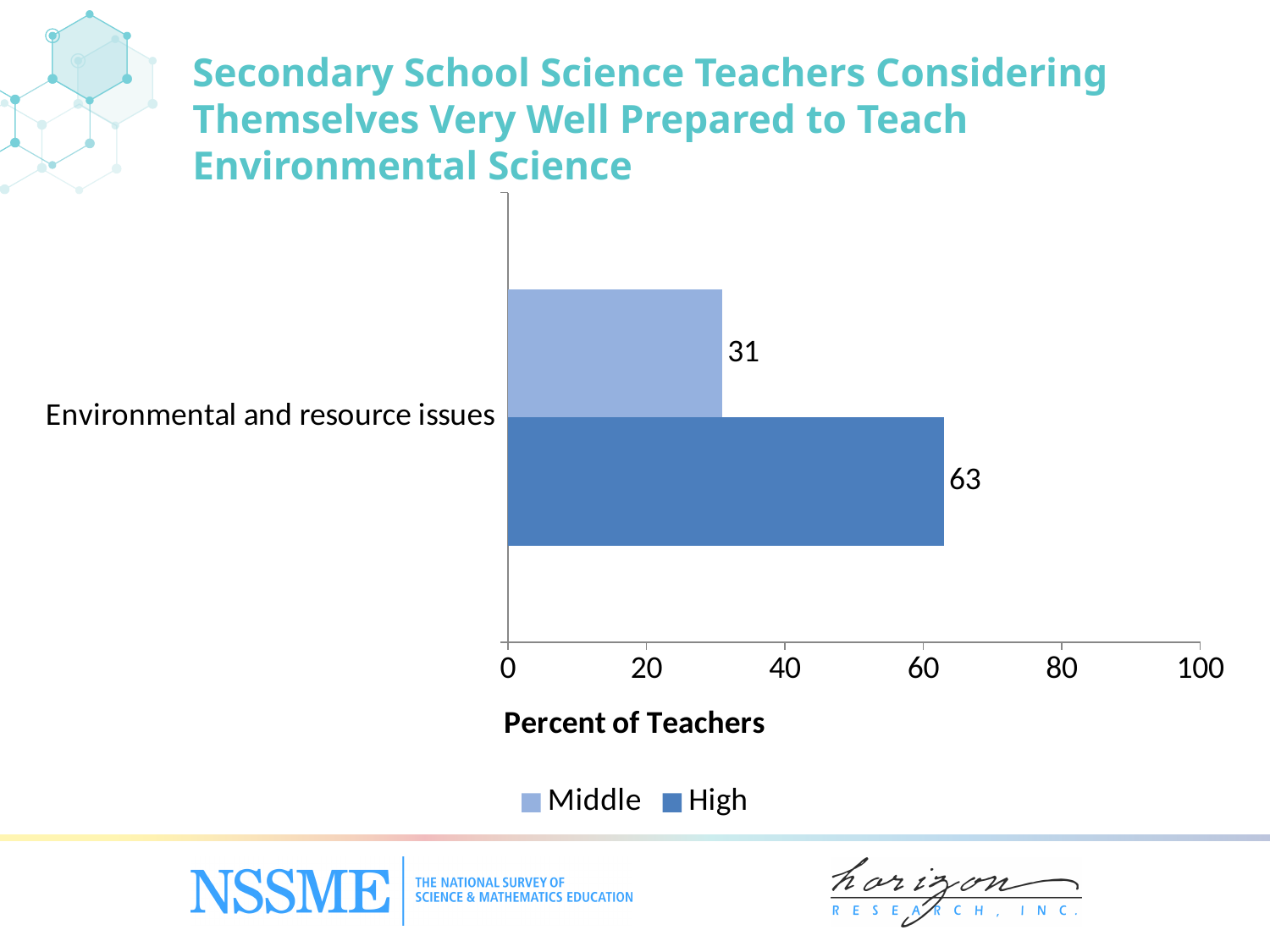
What is the maximum value shown on the x axis? 100 Is the value for Middle greater or less than 40? less What is the value for High school teachers for Environmental and resource issues? 63 Which series has the higher value for Environmental and resource issues, Middle or High? High What is the value for Middle school teachers for Environmental and resource issues? 31 Which series is shown in the darker blue colour? High What is the label of the x axis? Percent of Teachers What kind of chart is shown on the slide? Bar chart How many series does the legend list? 2 Is the value for High greater or less than 60? greater What is the difference between the High and Middle values for Environmental and resource issues? 32 How many categories are shown on the chart? 1